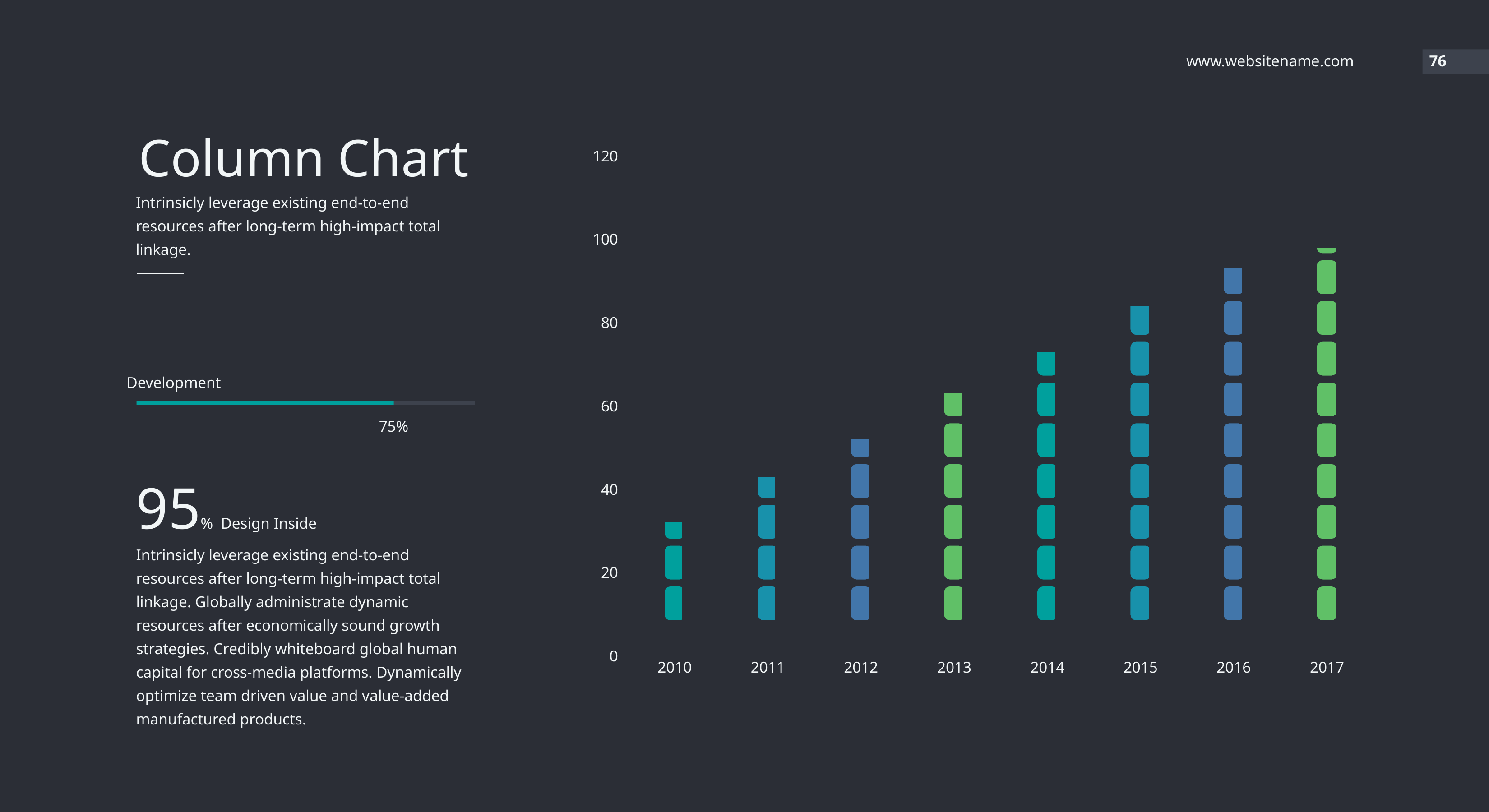
What kind of chart is shown on the slide? bar chart What is the highest value shown on the y axis of the chart? 120 Which year has the larger value, 2014 or 2012? 2014 Which year has the highest bar? 2017 Is the value for 2010 greater or less than 40? less Is the value for 2017 greater or less than 80? greater Do the bar values rise or fall from 2010 to 2017? rise Is the value for 2014 greater or less than 60? greater How many years are shown on the x axis of the chart? 8 Which year has the lowest bar? 2010